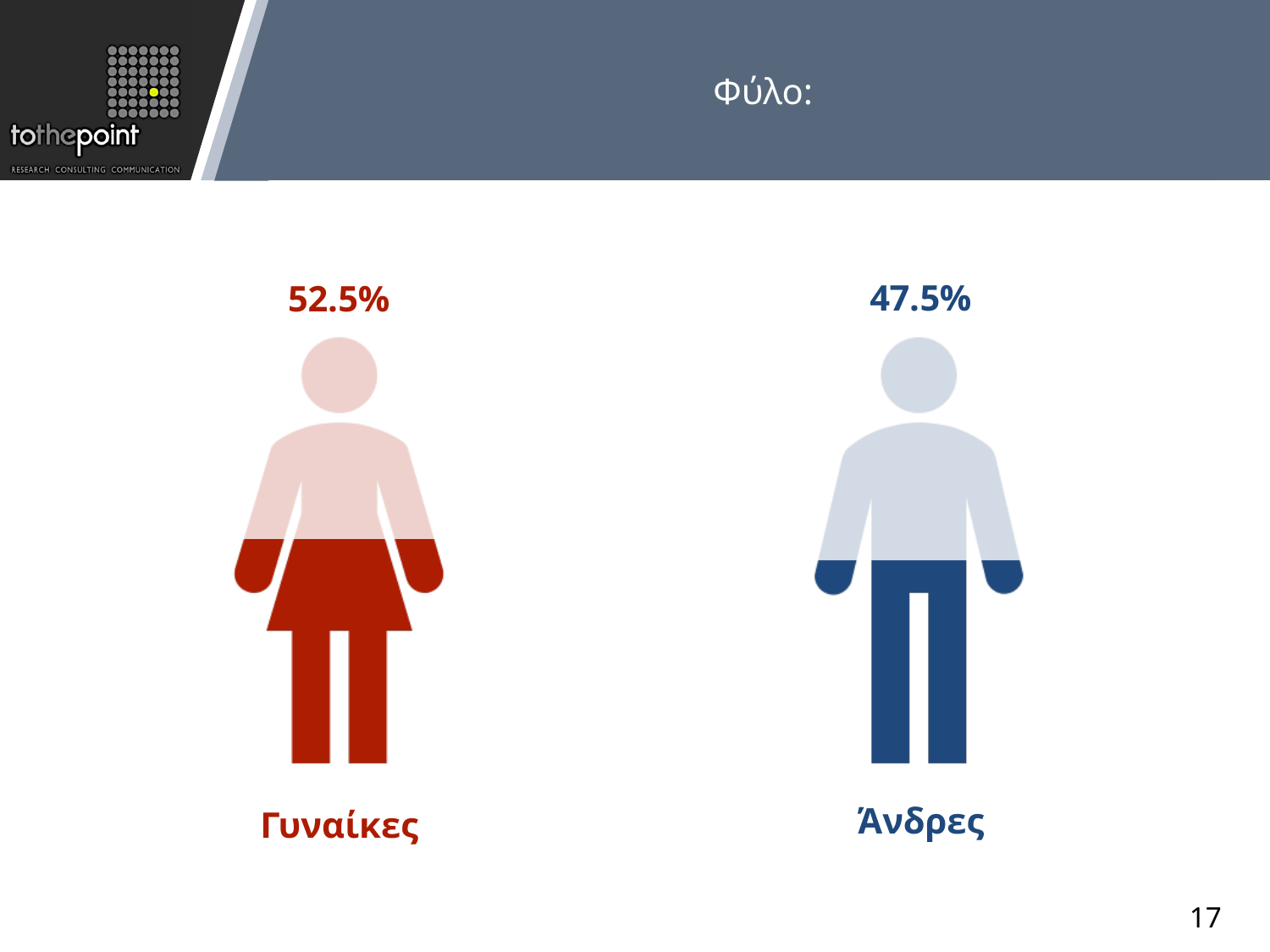
What do the two percentages on the slide add up to? 100% How many groups are shown on the slide? 2 What percentage is shown for Γυναίκες? 52.5% Which group has the lower percentage? Άνδρες What percentage is shown for Άνδρες? 47.5% What is the difference in percentage points between Γυναίκες and Άνδρες? 5 percentage points What is the title of the slide? Φύλο: Is the value for Γυναίκες greater or less than 50%? greater Which group has the higher percentage, Γυναίκες or Άνδρες? Γυναίκες Is the value for Άνδρες larger or smaller than the value for Γυναίκες? smaller Is the value for Άνδρες greater or less than 50%? less What colour is used for the Άνδρες figure? blue